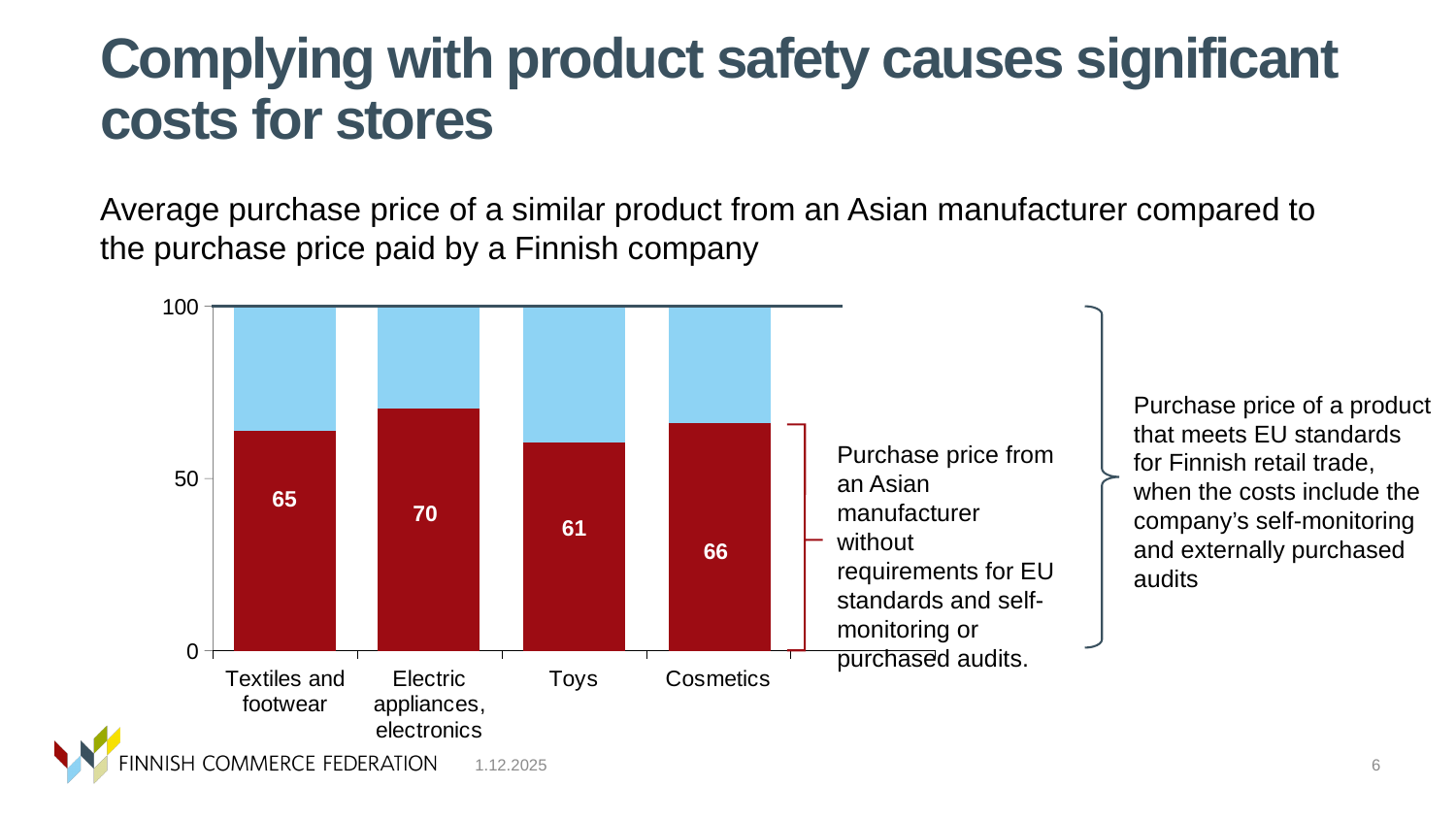
What is the purchase price from an Asian manufacturer for Electric appliances, electronics? 70 What is the purchase price from an Asian manufacturer for Textiles and footwear? 65 How many product categories are shown on the x axis? 4 What kind of chart is shown on the slide? Stacked bar chart Which category has the highest purchase price from an Asian manufacturer? Electric appliances, electronics What is the total height of each stacked bar on the chart? 100 Which category has the lowest purchase price from an Asian manufacturer? Toys What is the purchase price from an Asian manufacturer for Cosmetics? 66 Is the Asian manufacturer purchase price for Toys greater or less than 50? greater Which has a higher Asian manufacturer purchase price, Cosmetics or Textiles and footwear? Cosmetics What is the difference between the Asian manufacturer purchase price for Electric appliances, electronics and for Toys? 9 What is the purchase price from an Asian manufacturer for Toys? 61